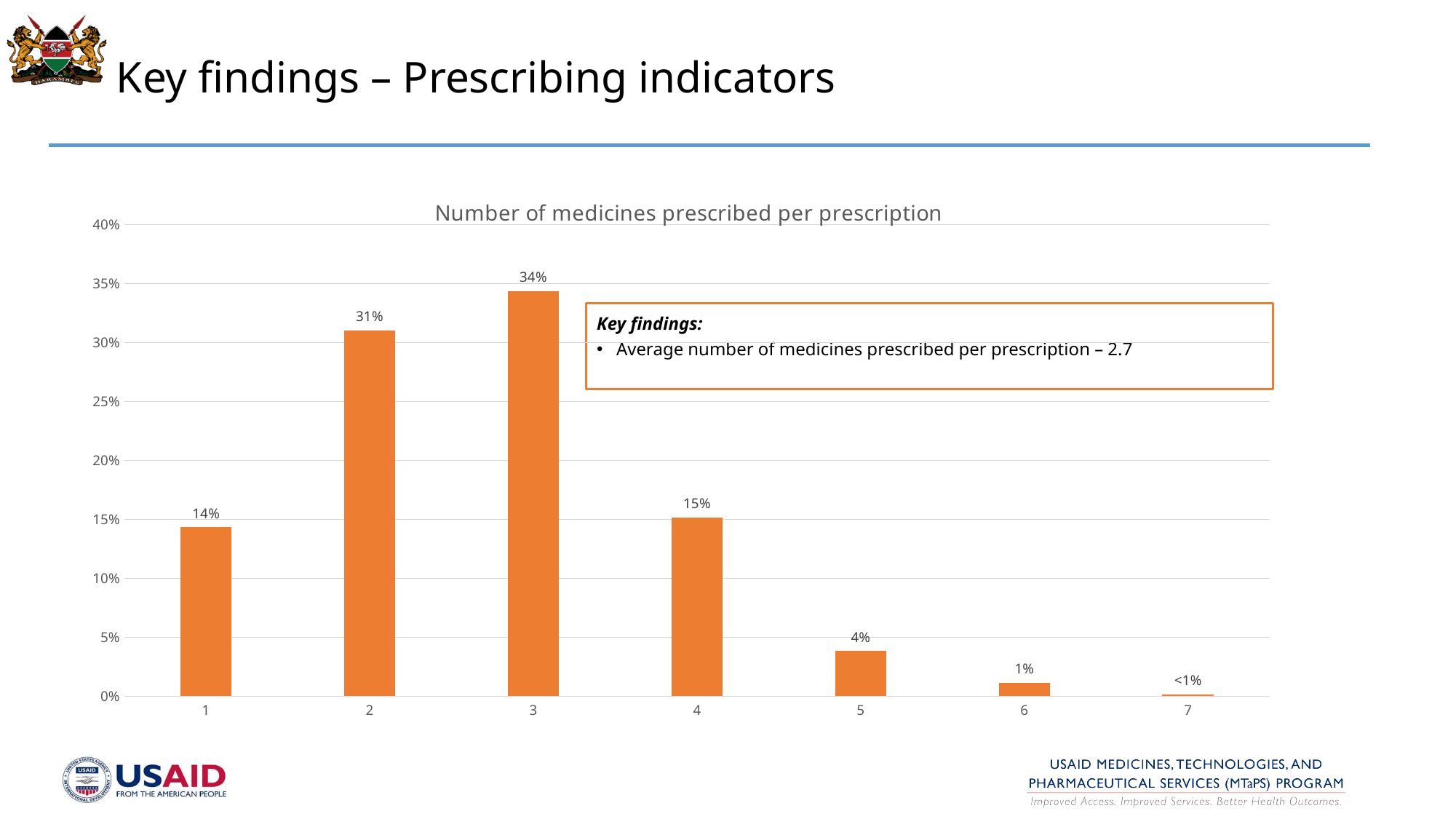
Which number of medicines per prescription has the highest percentage? 3 What is the difference between the values for category 4 and category 1? 1% Which is larger, the value for category 1 or the value for category 4? 4 How many categories are shown on the x axis of the chart? 7 Is the value for category 2 greater or less than 30%? greater What type of chart is shown on the slide? Bar chart What percentage of prescriptions had 3 medicines prescribed? 34% What is the value shown for category 5? 4% Which number of medicines per prescription has the lowest percentage? 7 What is the difference in percentage points between category 3 and category 2? 3% What is the data label shown for category 7? <1% What is the value shown for category 2 in the chart? 31%